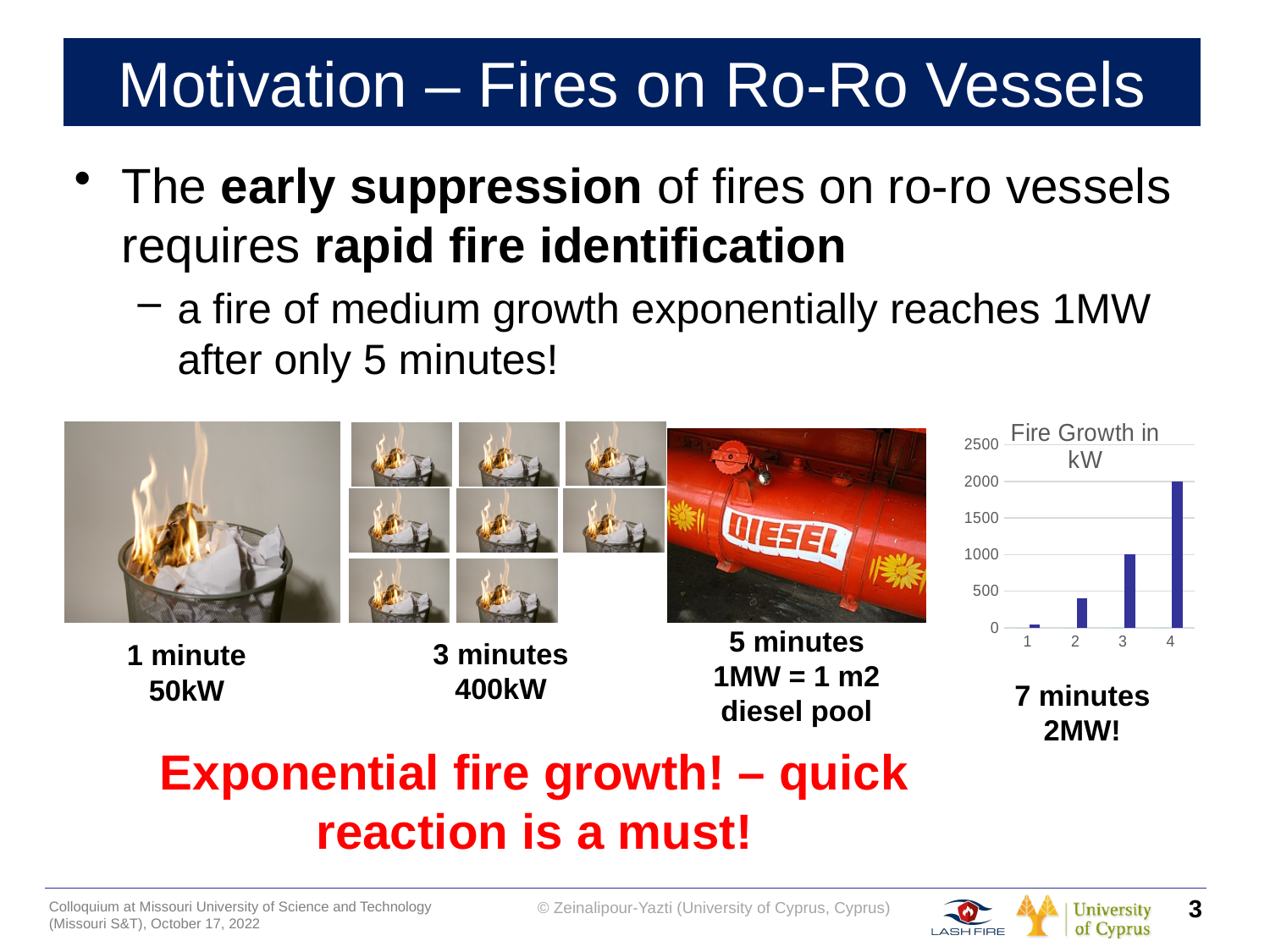
In the Fire Growth in kW chart, what value does the bar for category 3 reach? 1000 What kind of chart is the Fire Growth in kW chart? bar chart In the Fire Growth in kW chart, do the values rise or fall from category 1 to category 4? rise In the Fire Growth in kW chart, which is larger, the value for category 2 or the value for category 3? 3 What is the title of the chart on the slide? Fire Growth in kW In the Fire Growth in kW chart, which category has the lowest value? 1 In the Fire Growth in kW chart, is the value for category 4 greater or less than 1500? greater How many bars are plotted in the Fire Growth in kW chart? 4 In the Fire Growth in kW chart, what value does the bar for category 4 reach? 2000 In the Fire Growth in kW chart, is the value for category 2 greater or less than 500? less In the Fire Growth in kW chart, what is the difference between the values for category 4 and category 3? 1000 In the Fire Growth in kW chart, which category has the highest value? 4